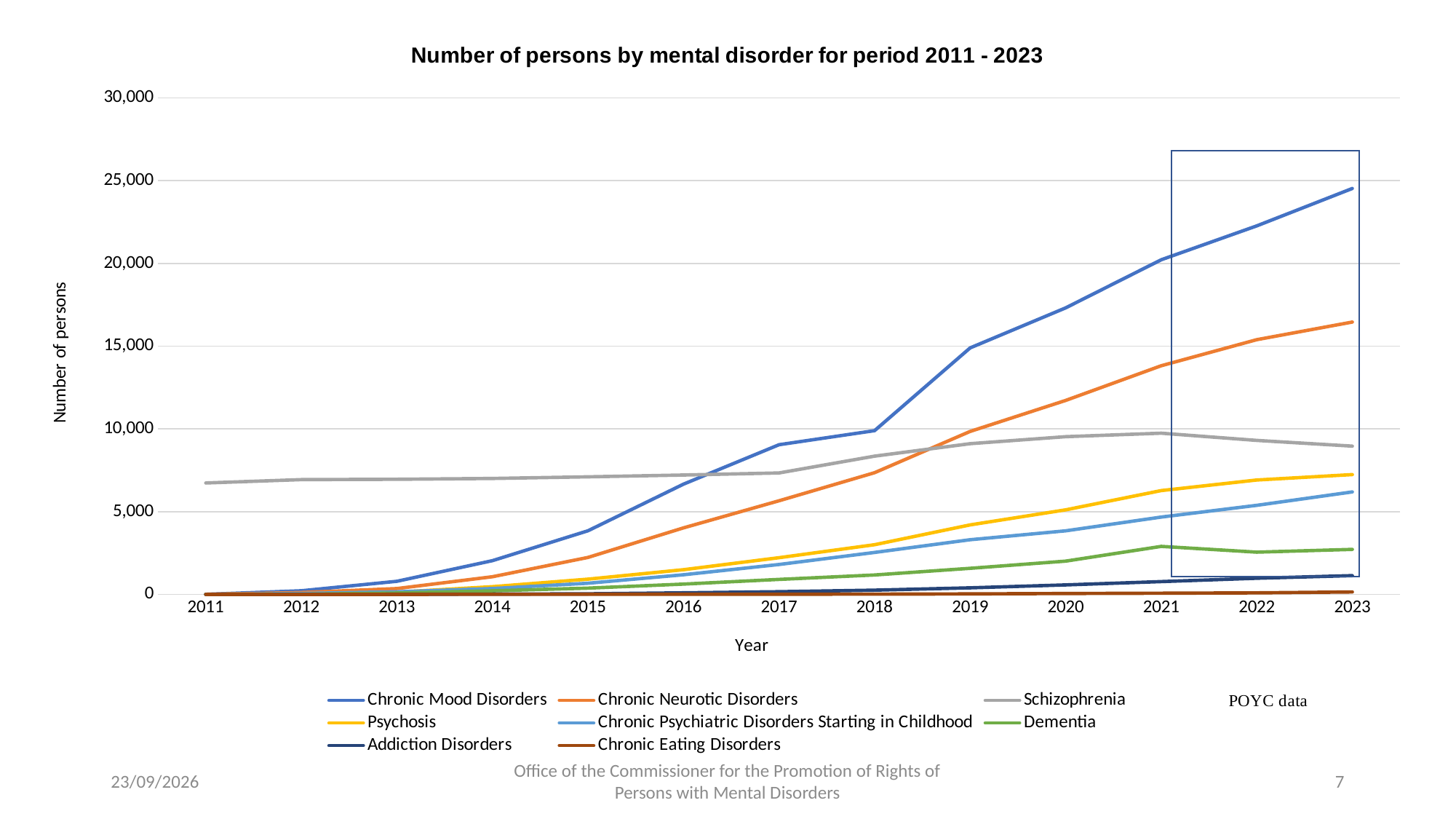
In 2017, which is larger: Chronic Mood Disorders or Schizophrenia? Chronic Mood Disorders Which mental disorder has the lowest number of persons in 2023? Chronic Eating Disorders Does the Chronic Mood Disorders line rise or fall from 2011 to 2023? rise Is the value for Chronic Mood Disorders in 2023 greater or less than 20,000? greater Which mental disorder has the highest number of persons in 2011? Schizophrenia Is the value for Schizophrenia in 2023 greater or less than 10,000? less Which mental disorder has the highest number of persons in 2023? Chronic Mood Disorders Is the value for Chronic Neurotic Disorders in 2023 greater or less than 15,000? greater What kind of chart is shown on the slide? line chart How many series does the legend list? 8 How many years are shown on the x axis? 13 What is the title of the chart? Number of persons by mental disorder for period 2011 - 2023